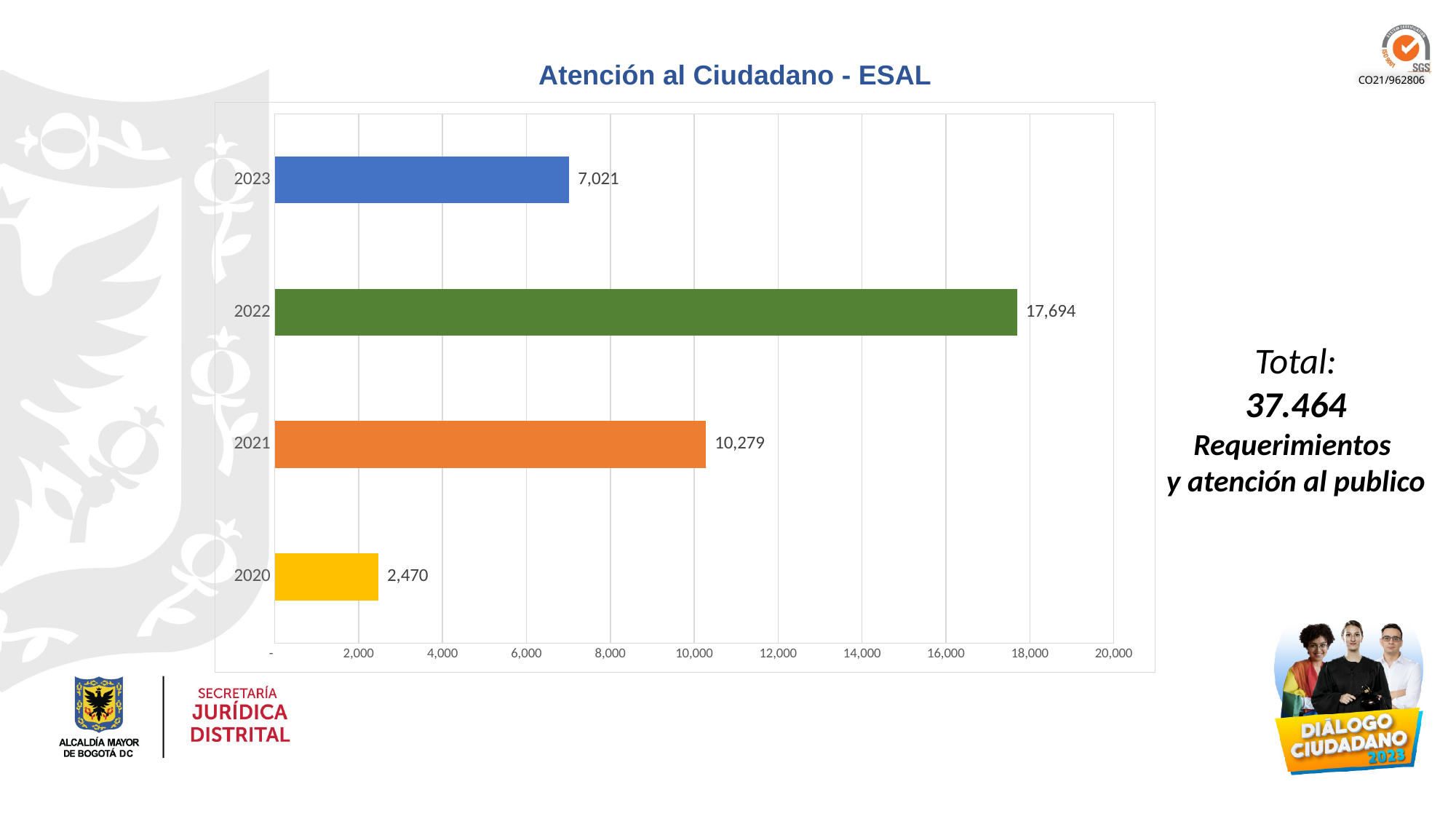
What kind of chart is shown? Bar chart What is the value for 2021? 10,279 What is the value for 2023? 7,021 Which year has the highest value? 2022 Which is larger, the value for 2023 or the value for 2021? 2021 What is the difference between the values for 2022 and 2021? 7,415 What is the value for 2022? 17,694 What is the title of the chart? Atención al Ciudadano - ESAL How many years are shown in the chart? 4 Which year has the lowest value? 2020 Is the value for 2022 greater or less than 16,000? greater What is the value for 2020? 2,470